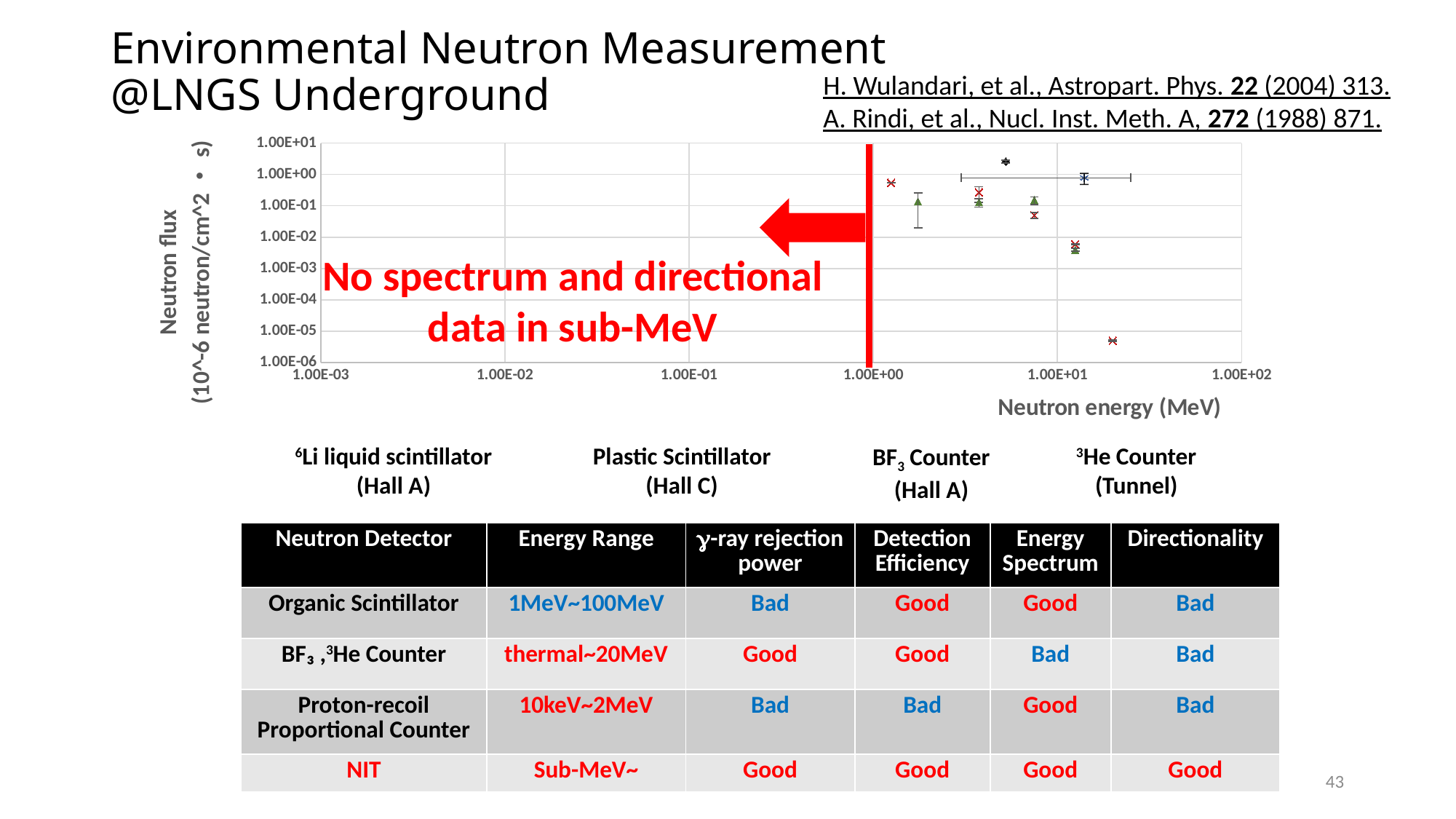
Which is larger: the neutron flux of the point plotted near 5 MeV or the flux of the point plotted near 20 MeV? the point near 5 MeV Is the neutron flux of the data point near 1.00E+01 MeV with the horizontal error bar greater or less than 1.00E-01? greater Is the lowest plotted neutron flux value greater or less than 1.00E-04? less Is the highest plotted neutron flux value greater or less than 1.00E+00? greater What is the title of the x axis of the chart? Neutron energy (MeV) What quantity is plotted on the y axis of the chart? Neutron flux (10^-6 neutron/cm^2 • s) What kind of chart is shown on the slide? scatter chart